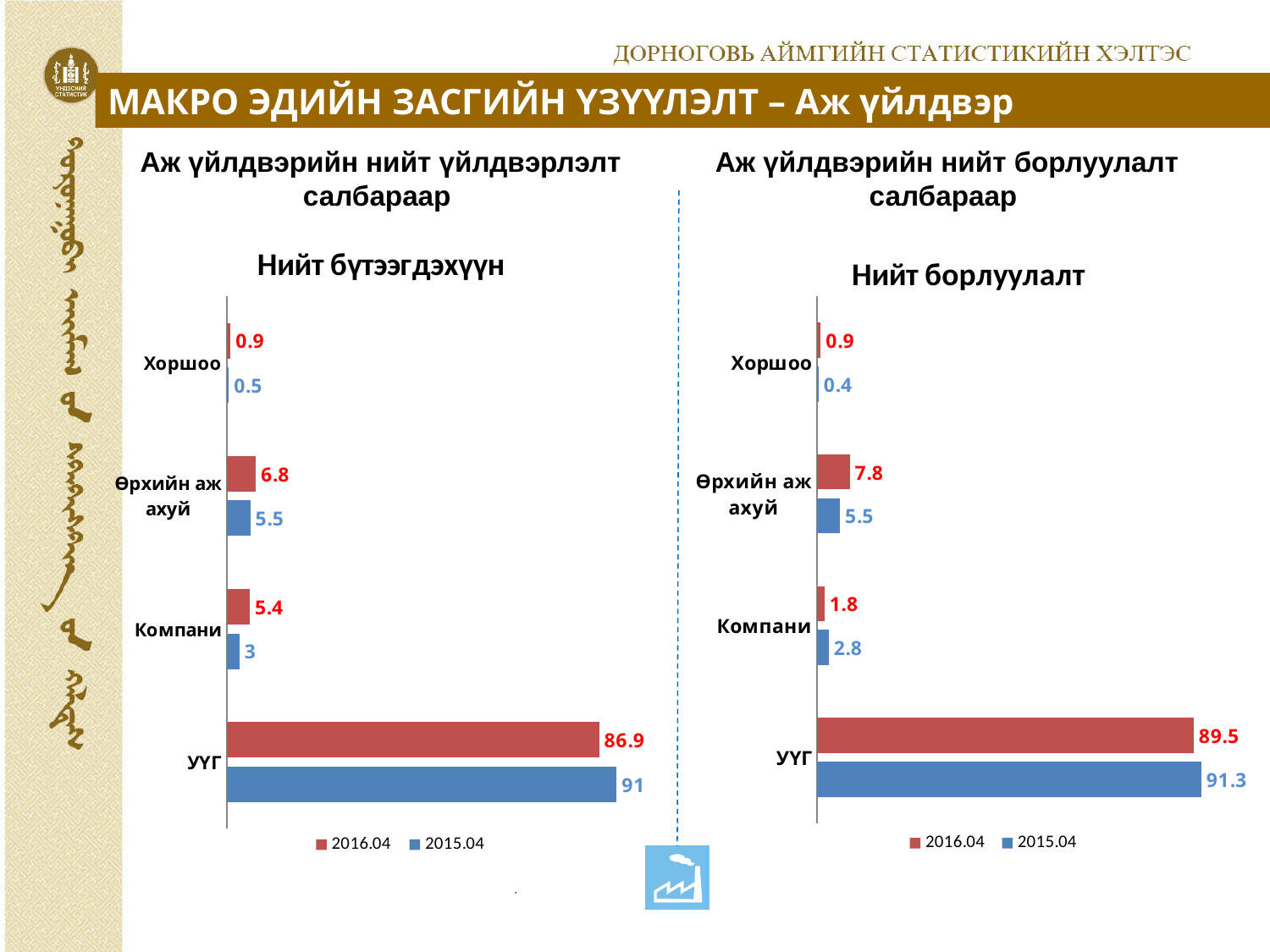
How many series does the legend of the 'Нийт борлуулалт' chart list? 2 How many categories are shown in the 'Нийт бүтээгдэхүүн' chart? 4 In the 'Нийт борлуулалт' chart, which is larger for Компани: the 2016.04 value or the 2015.04 value? 2015.04 In the 'Нийт бүтээгдэхүүн' chart, what is the difference between the 2015.04 and 2016.04 values for УҮГ? 4.1 In the 'Нийт бүтээгдэхүүн' chart, what is the value for Компани in 2015.04? 3 What type of chart is the 'Нийт бүтээгдэхүүн' chart? Bar chart In the 'Нийт бүтээгдэхүүн' chart, which category has the highest value for 2015.04? УҮГ In the 'Нийт борлуулалт' chart, what is the value for Өрхийн аж ахуй in 2016.04? 7.8 In the 'Нийт борлуулалт' chart, which category has the lowest value for 2016.04? Хоршоо In the 'Нийт бүтээгдэхүүн' chart, what is the value for УҮГ in 2016.04? 86.9 In the 'Нийт борлуулалт' chart, what is the value for Хоршоо in 2015.04? 0.4 In the 'Нийт борлуулалт' chart, what is the difference between the 2016.04 and 2015.04 values for Өрхийн аж ахуй? 2.3